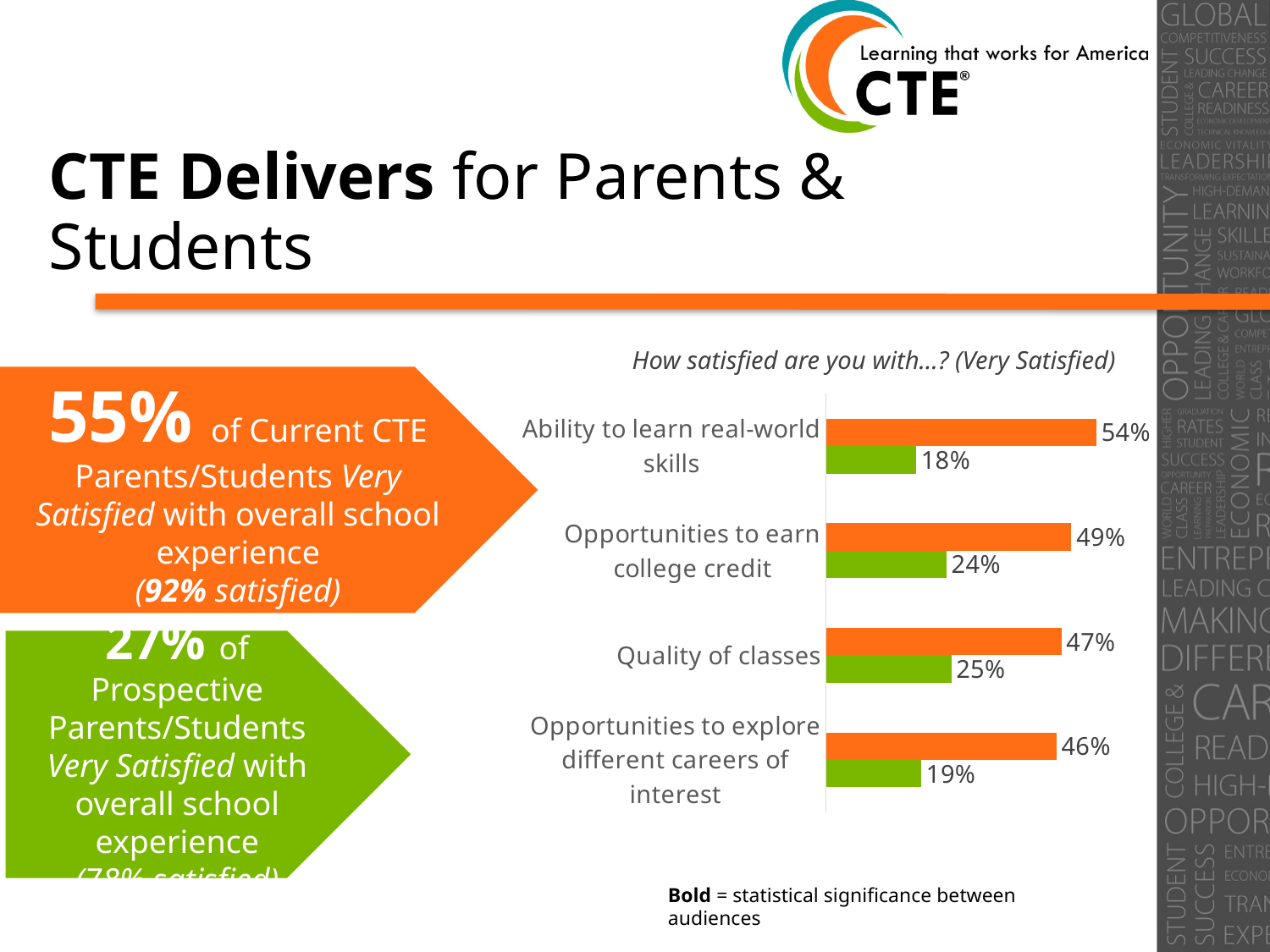
Which is larger: the green bar for "Quality of classes" or the green bar for "Opportunities to explore different careers of interest"? Quality of classes Which category has the lowest green bar value? Ability to learn real-world skills What is the value of the green bar for "Opportunities to earn college credit"? 24% What is the difference between the orange and green bar values for "Ability to learn real-world skills"? 36% How many categories does the chart show? 4 What kind of chart is shown on the slide? bar chart What is the value of the orange bar for "Quality of classes"? 47% What is the value of the orange bar for "Ability to learn real-world skills"? 54% What is the value of the green bar for "Opportunities to explore different careers of interest"? 19% Which category has the highest orange bar value? Ability to learn real-world skills What is the title of the chart? How satisfied are you with...? (Very Satisfied) What is the value of the green bar for "Ability to learn real-world skills"? 18%